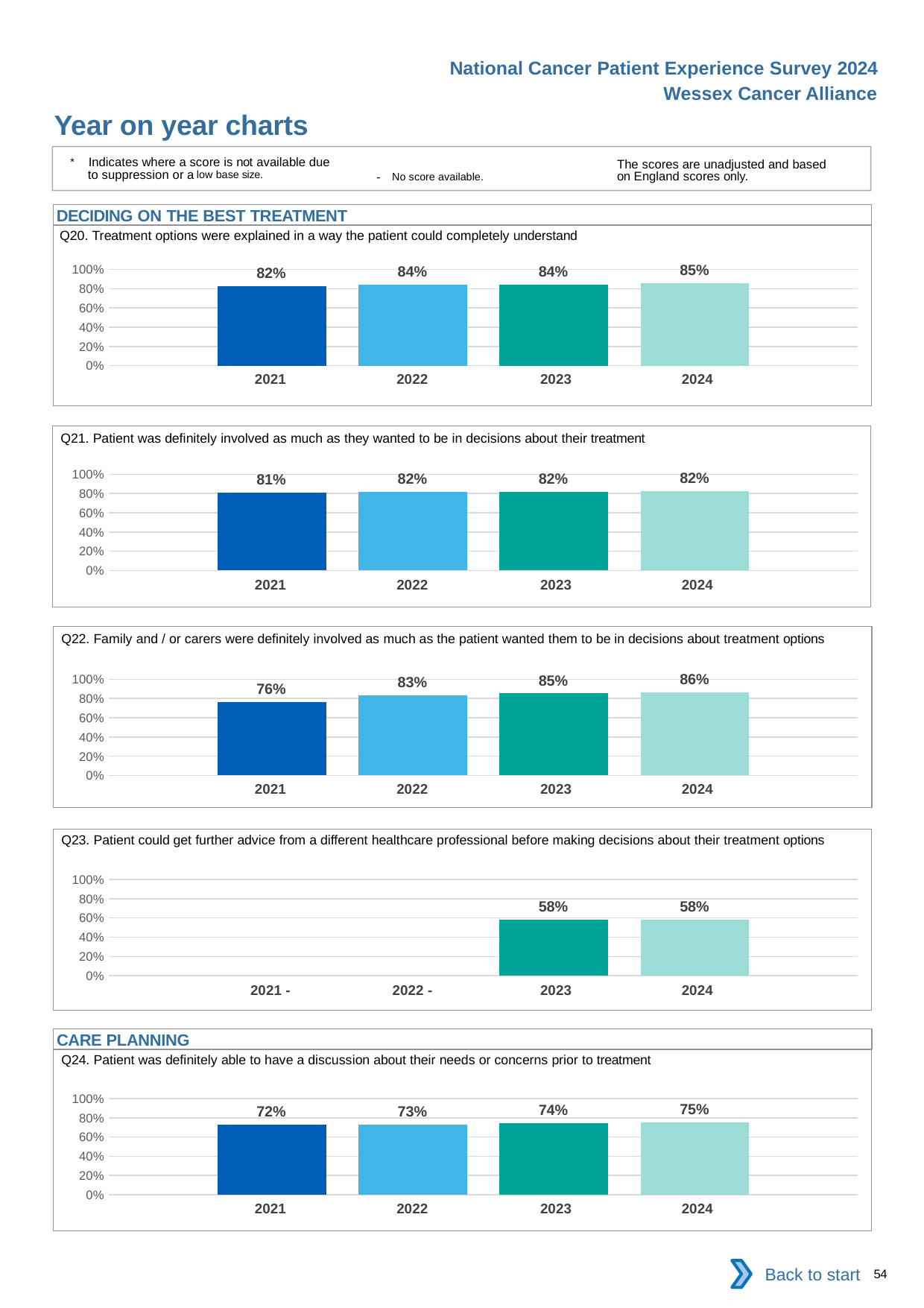
In the Q20 chart (Treatment options were explained in a way the patient could completely understand), which year has the larger value, 2021 or 2024? 2024 In the Q23 chart (Patient could get further advice from a different healthcare professional), how many years have a score shown? 2 In the Q22 chart (Family and / or carers were definitely involved), which year has the lowest value? 2021 In the Q20 chart (Treatment options were explained in a way the patient could completely understand), what is the value for 2024? 85% In the Q24 chart (Patient was definitely able to have a discussion about their needs or concerns prior to treatment), do the values rise or fall from 2021 to 2024? rise In the Q24 chart (Patient was definitely able to have a discussion about their needs or concerns prior to treatment), what is the difference between the 2024 and 2021 values? 3 percentage points In the Q21 chart (Patient was definitely involved as much as they wanted to be in decisions about their treatment), what is the value for 2021? 81% In the Q24 chart (Patient was definitely able to have a discussion about their needs or concerns prior to treatment), which year has the highest value? 2024 In the Q22 chart (Family and / or carers were definitely involved), what is the difference between the 2024 and 2021 values? 10 percentage points In the Q23 chart (Patient could get further advice from a different healthcare professional), what is the value for 2023? 58% What kind of chart is the Q20 chart (Treatment options were explained in a way the patient could completely understand)? bar chart In the Q22 chart (Family and / or carers were definitely involved), what is the value for 2021? 76%